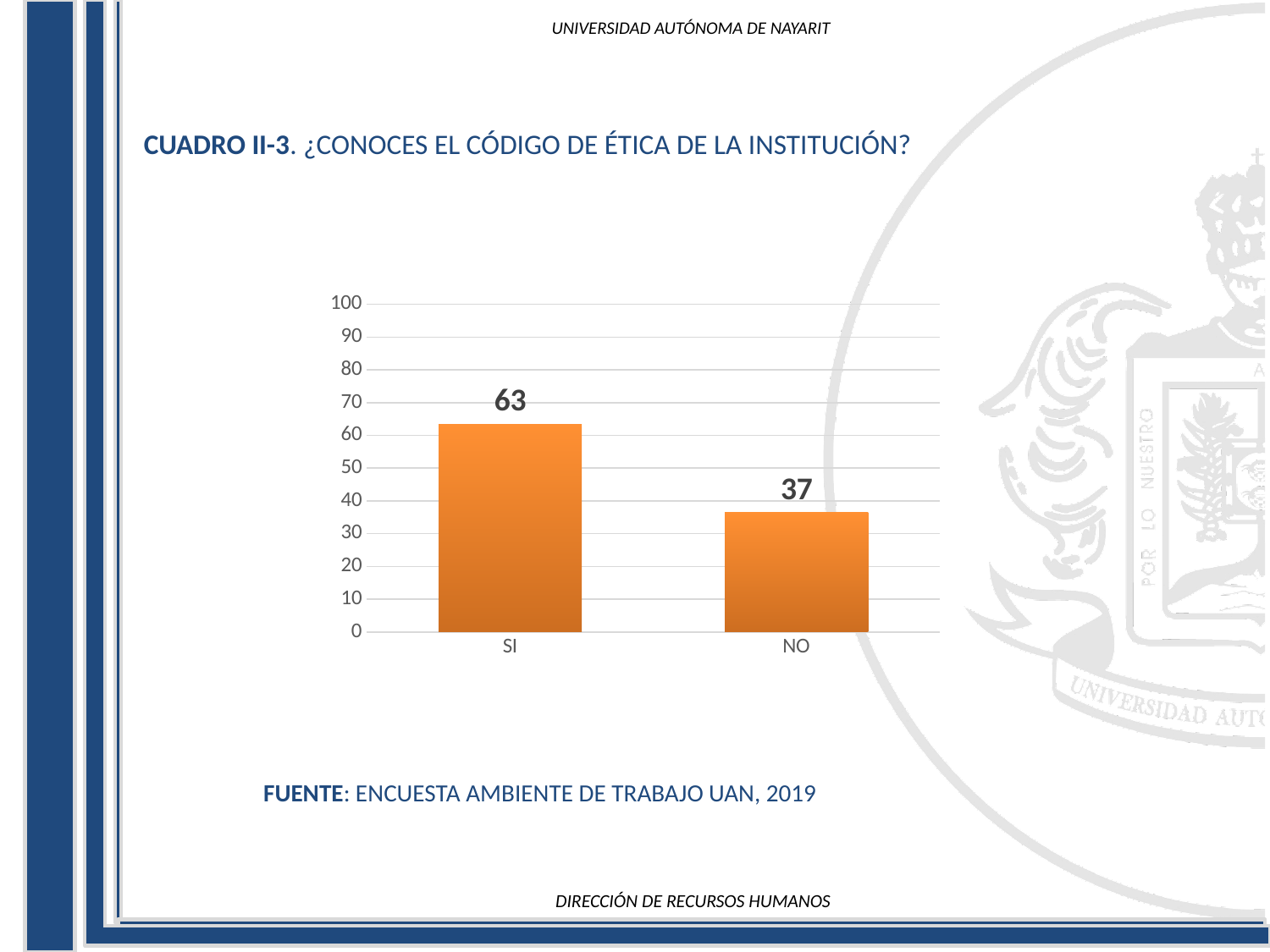
What is the maximum value shown on the vertical axis? 100 What is the value for SI? 63 What is the total of the two bars? 100 What kind of chart is shown on the slide? bar chart Which is larger, the value for SI or the value for NO? SI Which category has the lowest value? NO How many categories are shown on the x axis? 2 Which category has the highest value? SI Is the value for NO greater or less than 40? less What is the value for NO? 37 Is the value for SI greater or less than 50? greater What is the difference between the values for SI and NO? 26